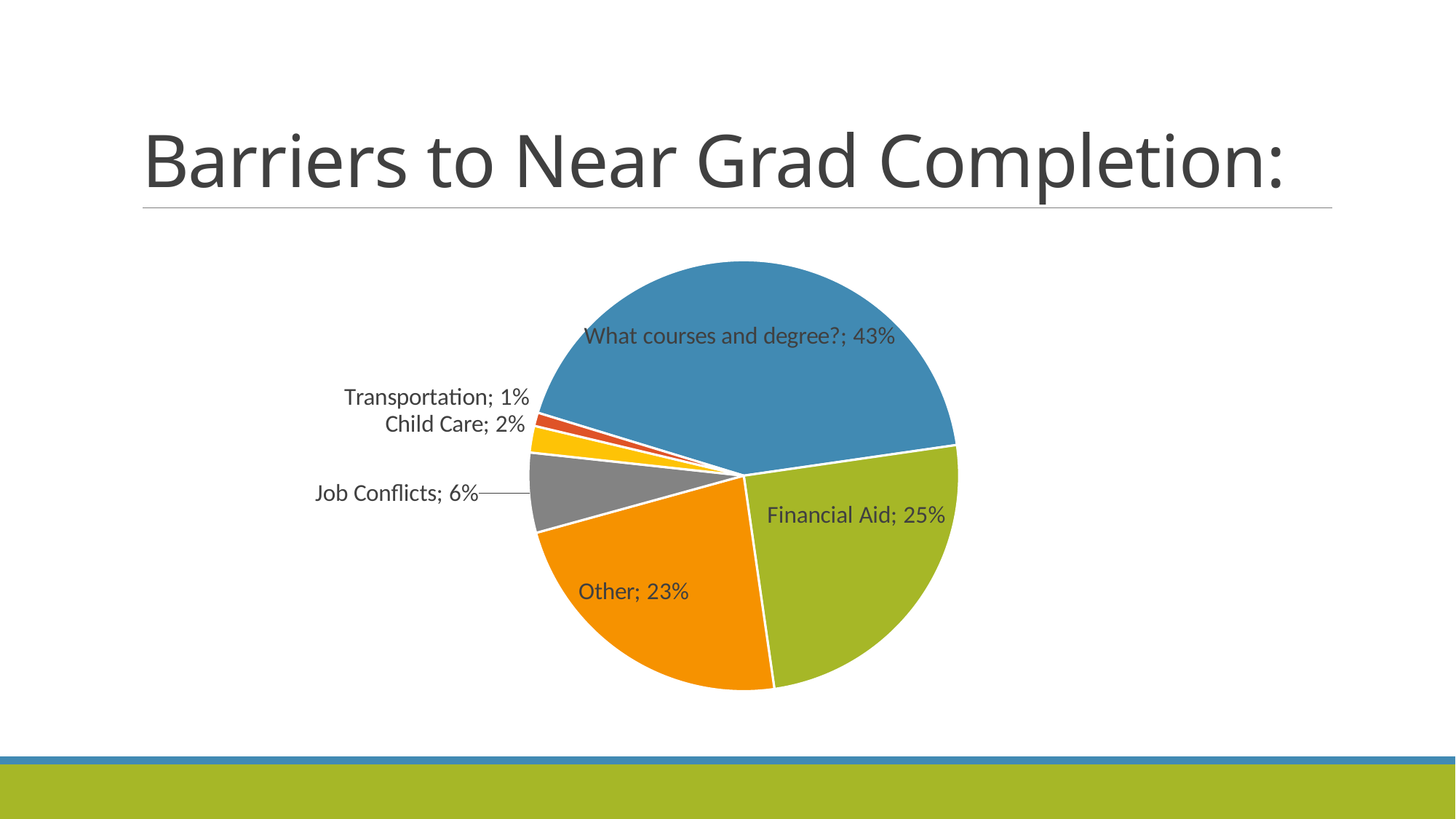
What share of the pie is labelled "Other"? 23% What share of the pie is labelled "Child Care"? 2% What share of the pie is labelled "Job Conflicts"? 6% How many slices does the pie chart have? 6 What kind of chart is shown on the slide? Pie chart Which slice of the pie is the smallest? Transportation What is the difference in percentage points between the "Financial Aid" slice and the "Other" slice? 2 Which is larger, the "Job Conflicts" slice or the "Child Care" slice? Job Conflicts Which slice of the pie is the largest? What courses and degree?